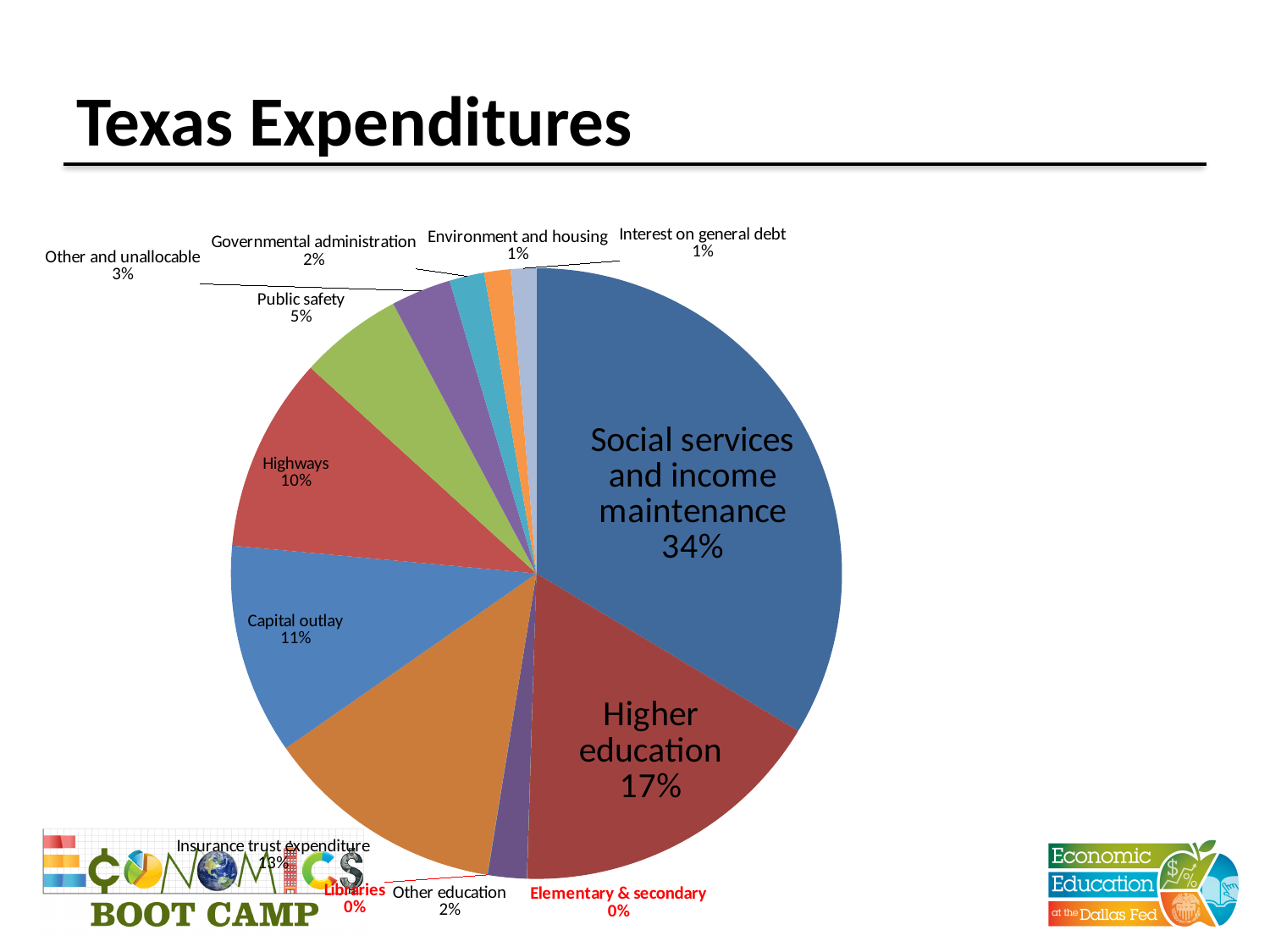
Which category has the largest slice of the pie? Social services and income maintenance What percentage is labeled for Governmental administration? 2% What percentage is shown for Highways? 10% What type of chart is shown on the slide? pie chart What share of Texas expenditures goes to Social services and income maintenance? 34% What is the difference in percentage points between Social services and income maintenance and Higher education? 17 Which is larger, Capital outlay or Highways? Capital outlay What percentage is shown for Other and unallocable? 3% What is the title of the slide containing the pie chart? Texas Expenditures What is the share for Capital outlay? 11% What percentage of the pie is Higher education? 17% What is the value shown for Public safety? 5%